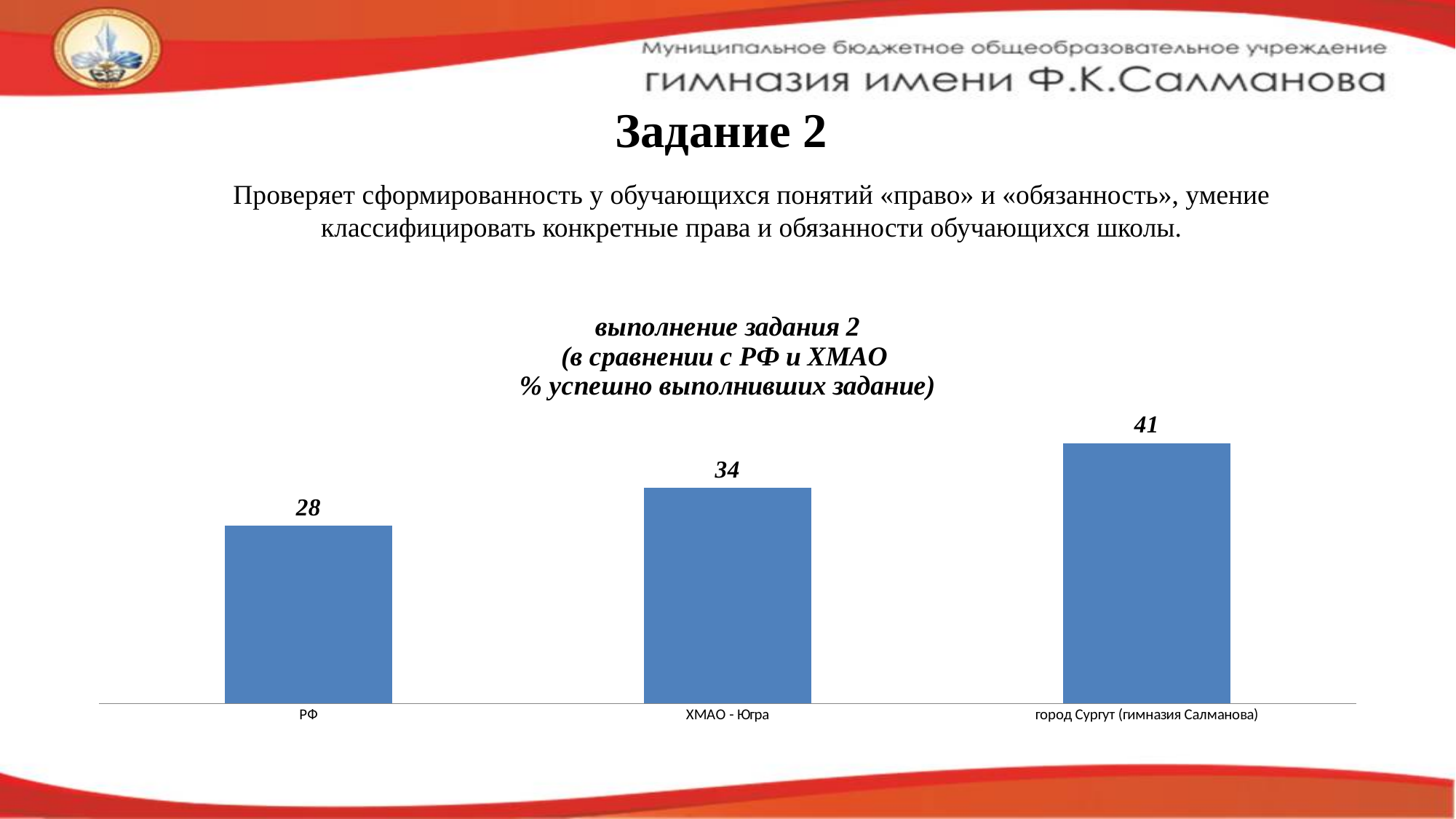
What is the value for ХМАО - Югра? 34 What is the difference between the values for ХМАО - Югра and РФ? 6 What is the difference between the values for город Сургут (гимназия Салманова) and РФ? 13 Which category has the highest value? город Сургут (гимназия Салманова) Which is larger, the value for ХМАО - Югра or the value for РФ? ХМАО - Югра What is the value for город Сургут (гимназия Салманова)? 41 What kind of chart is shown on the slide? bar chart What is the first line of the chart's title? выполнение задания 2 What is the value for РФ? 28 Do the values rise or fall from left to right along the x axis? rise How many categories are shown in the chart? 3 Which category has the lowest value? РФ